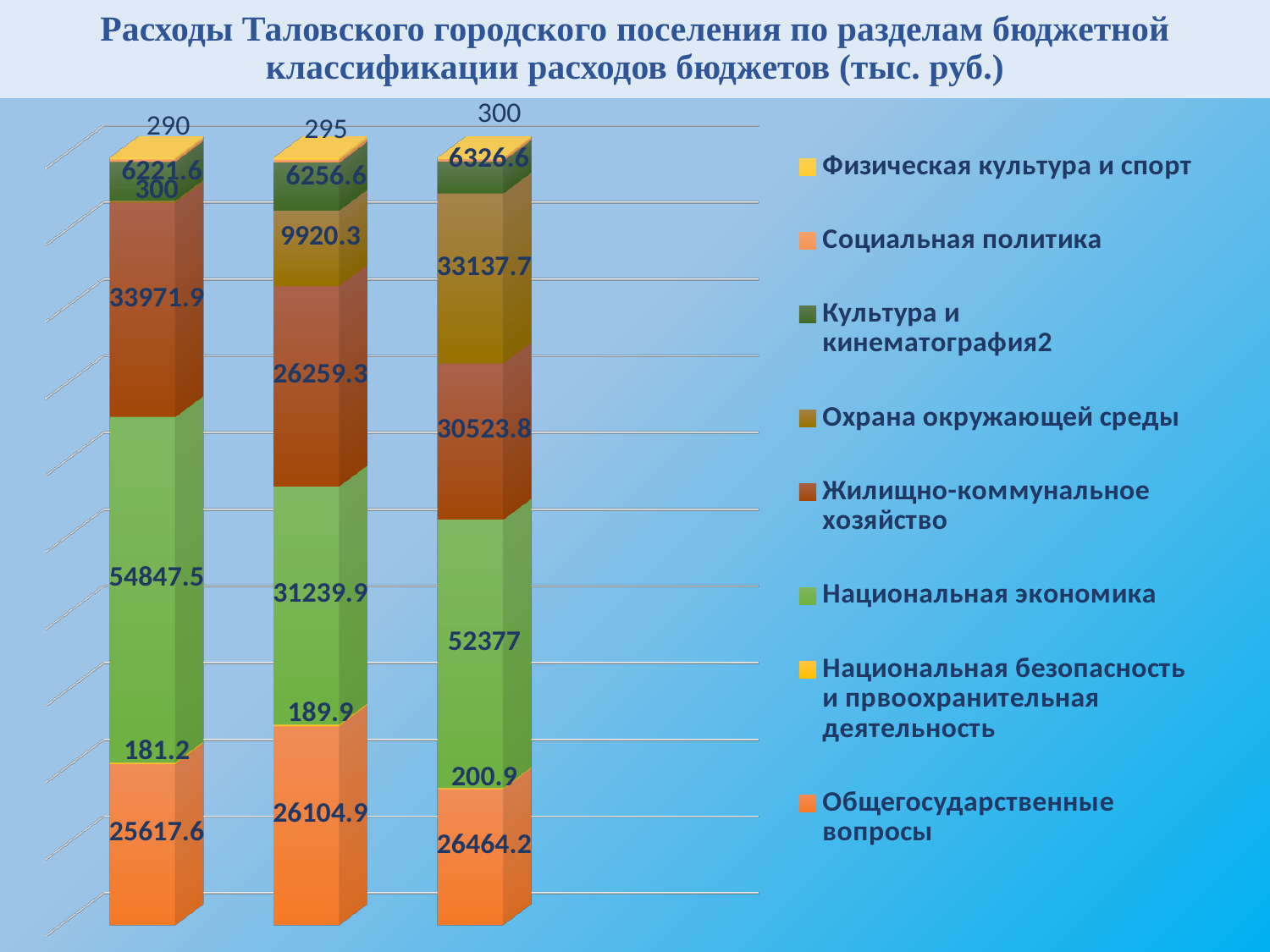
What is the value of the Культура и кинематография2 segment in the middle bar? 6256.6 Which bar has the largest Национальная экономика segment? The left bar Do the Общегосударственные вопросы values rise or fall from the left bar to the right bar? Rise How many series does the legend list? 8 How many stacked bars are plotted in the chart? 3 What is the value of the Общегосударственные вопросы segment in the left bar? 25617.6 Which bar has the smallest Национальная безопасность и правоохранительная деятельность segment? The left bar What is the value of the Национальная экономика segment in the right bar? 52377 Is the Жилищно-коммунальное хозяйство segment larger in the left bar or the middle bar? The left bar What is the difference between the Общегосударственные вопросы values in the right bar and the left bar? 846.6 What is the value of the Охрана окружающей среды segment in the middle bar? 9920.3 What kind of chart is shown on the slide? Stacked bar chart